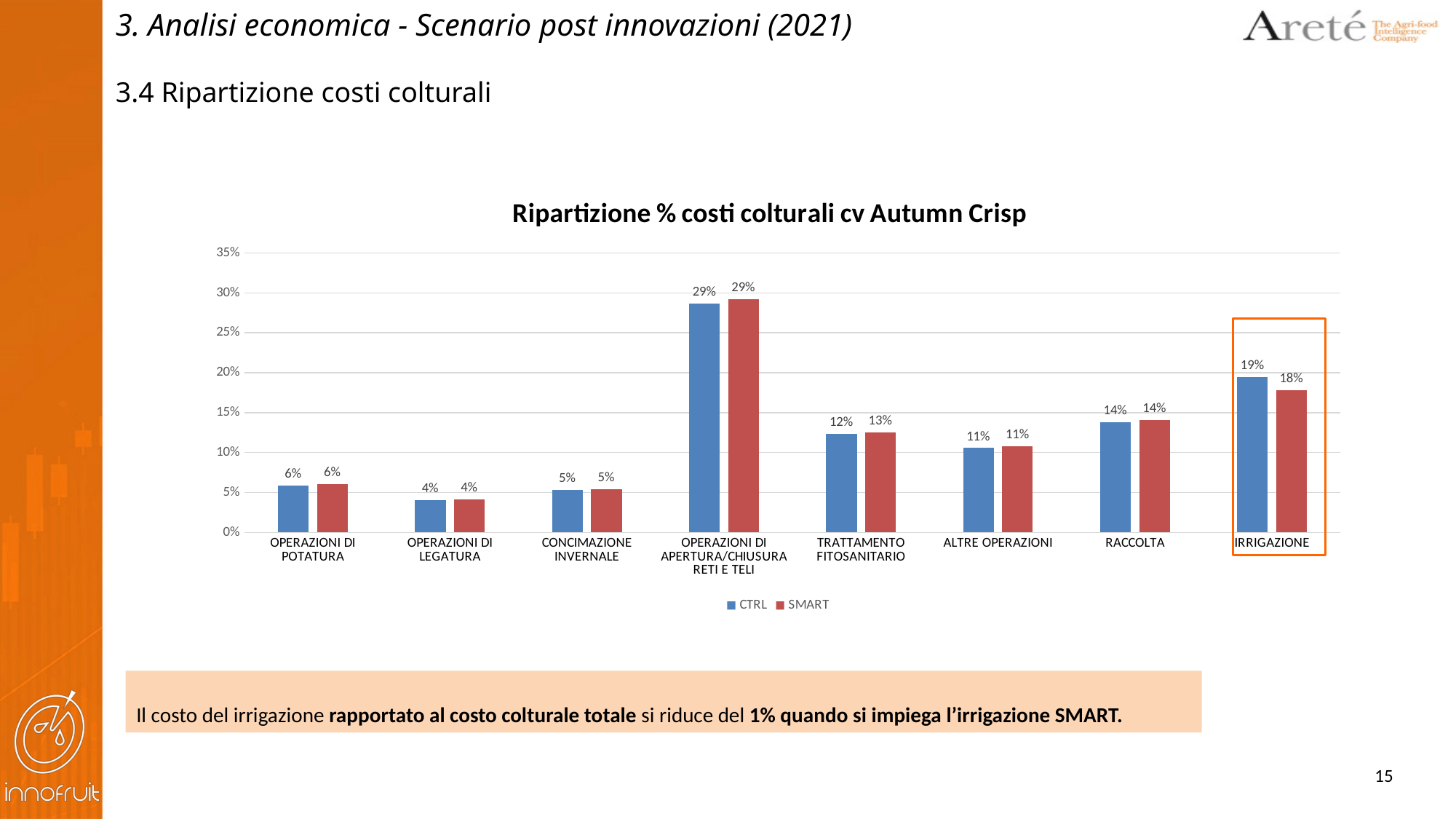
What is the title of the chart? Ripartizione % costi colturali cv Autumn Crisp How many series does the legend list? 2 Which category has the highest CTRL value? OPERAZIONI DI APERTURA/CHIUSURA RETI E TELI What is the CTRL value for IRRIGAZIONE? 19% Which is larger for IRRIGAZIONE, the CTRL value or the SMART value? CTRL What is the CTRL value for RACCOLTA? 14% What kind of chart is shown on the slide? Bar chart What is the difference between the CTRL and SMART values for IRRIGAZIONE? 1% Which category has the lowest SMART value? OPERAZIONI DI LEGATURA How many categories are shown on the x axis? 8 What is the SMART value for IRRIGAZIONE? 18% What is the SMART value for TRATTAMENTO FITOSANITARIO? 13%